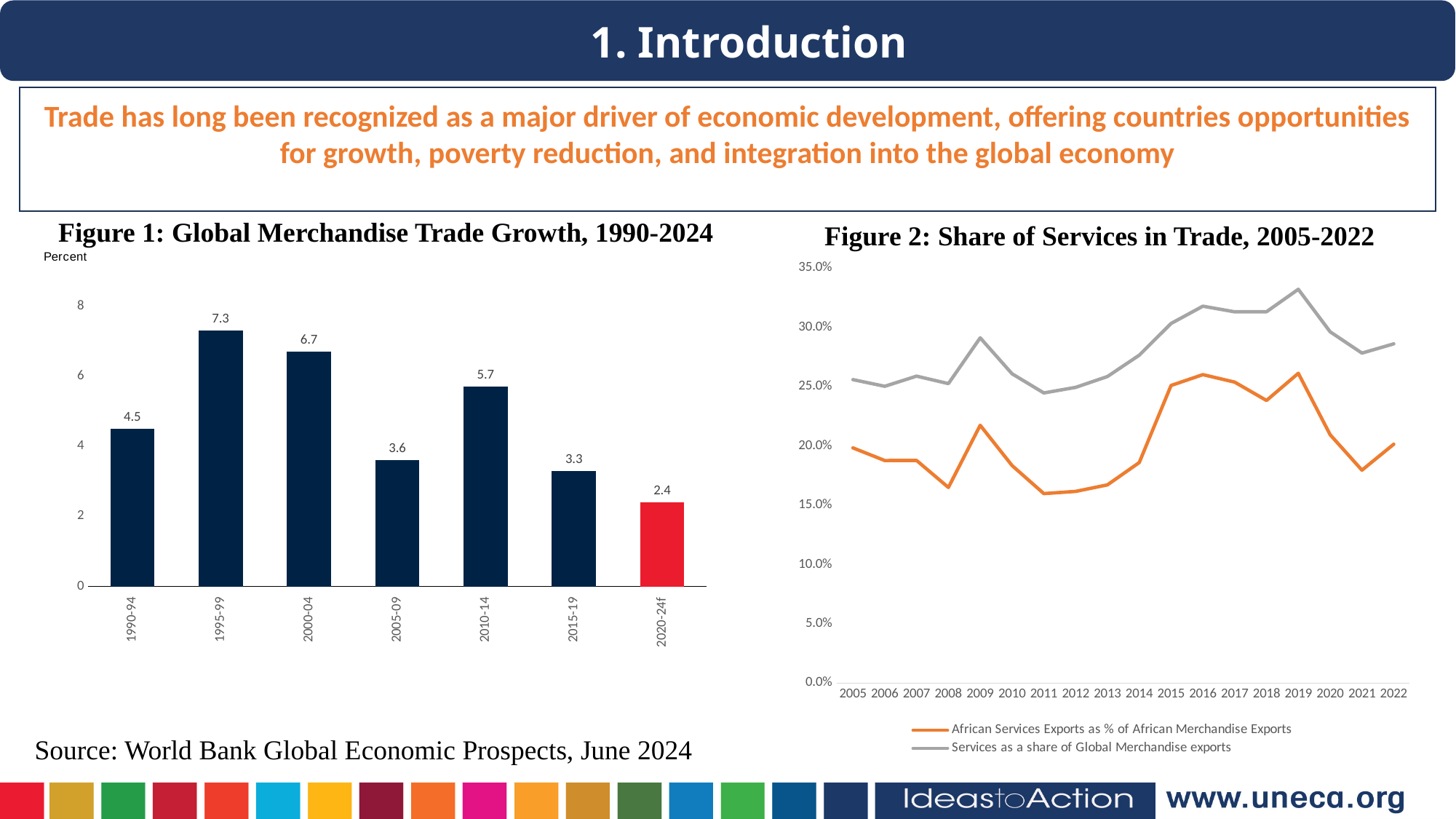
In Figure 1, how many periods are shown on the x axis? 7 In Figure 1, what is the difference between the values for 2000-04 and 2005-09? 3.1 In Figure 2, is the value for African Services Exports as % of African Merchandise Exports in 2011 greater or less than 20.0%? less In Figure 1, what is the global merchandise trade growth value for 1995-99? 7.3 In Figure 2, is the value for Services as a share of Global Merchandise exports in 2019 greater or less than 30.0%? greater In Figure 1, what is the value shown for 2020-24f? 2.4 In Figure 2, which series is drawn in orange? African Services Exports as % of African Merchandise Exports In Figure 1, which period has the lowest trade growth? 2020-24f In Figure 2, how many series does the legend list? 2 In Figure 1, which is larger, the value for 2010-14 or the value for 2015-19? 2010-14 What type of chart is Figure 1? Bar chart In Figure 1, which period has the highest trade growth? 1995-99